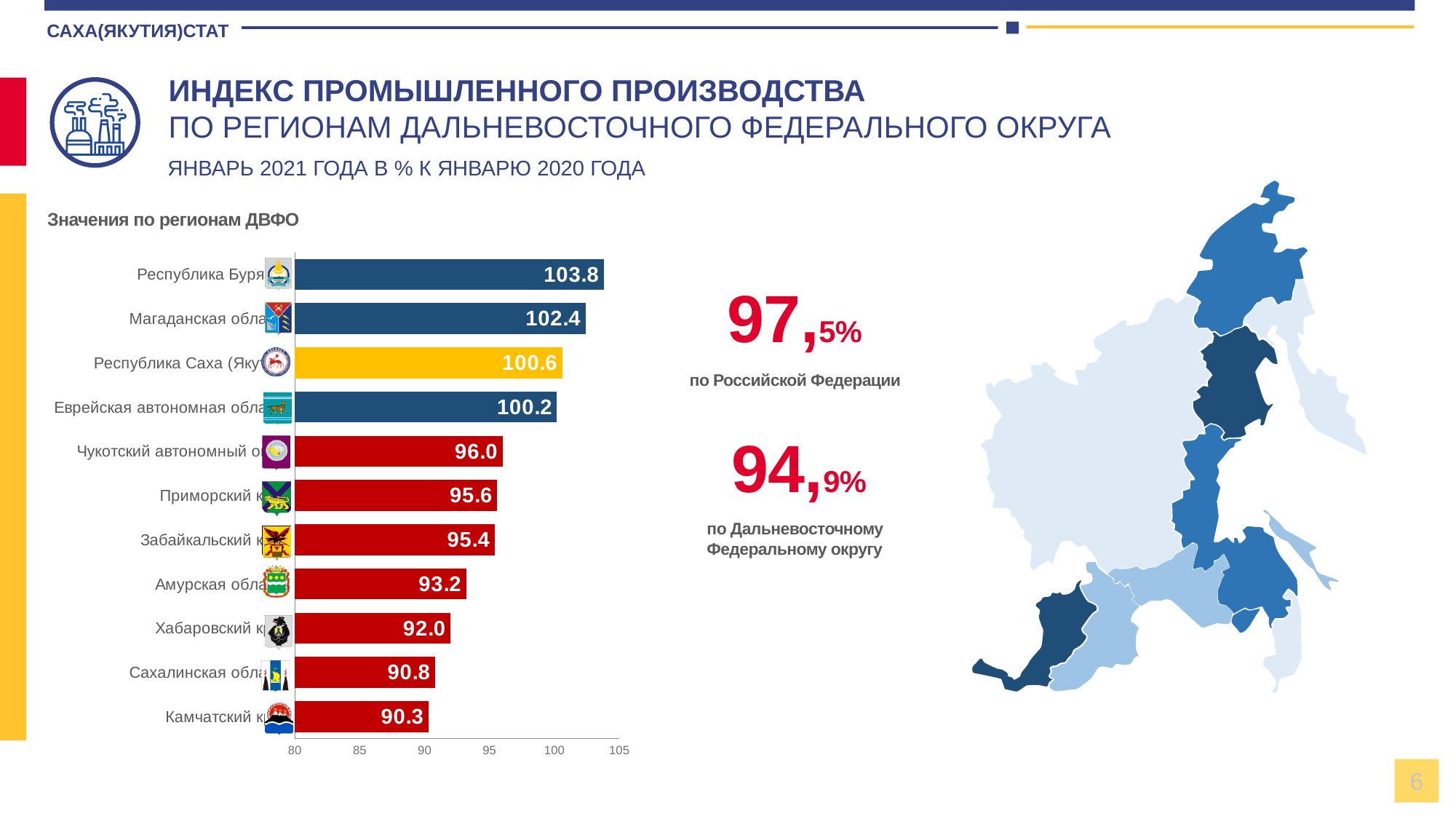
What is the difference between the values for Магаданская область and Амурская область? 9.2 Which region has the highest value on the chart? Республика Бурятия What is the difference between the values for Чукотский автономный округ and Камчатский край? 5.7 What kind of chart is shown on the slide? bar chart Is the value for Сахалинская область greater or less than 95? less How many regions are shown on the chart? 11 Which is larger, the value for Приморский край or the value for Забайкальский край? Приморский край Which region has the lowest value on the chart? Камчатский край What is the value for Хабаровский край? 92.0 What is the value for Республика Бурятия? 103.8 Which bar on the chart is coloured yellow? Республика Саха (Якутия) What is the value for Республика Саха (Якутия)? 100.6